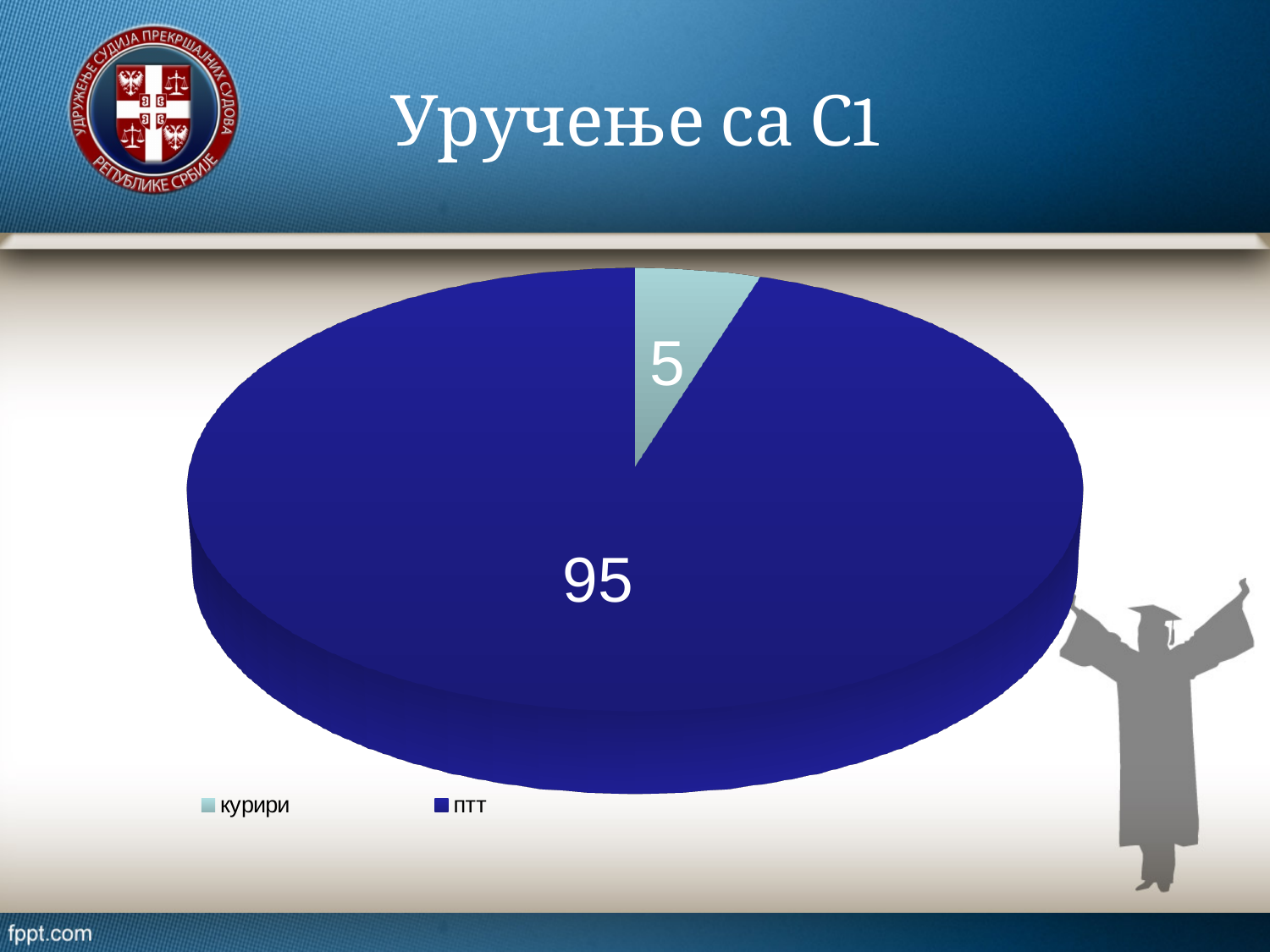
What is the value for курири? 5 Which category has the smallest slice? курири What is the total of the two slice values? 100 What is the title of the slide containing the chart? Уручење са С1 What is the value for птт? 95 How many entries does the legend list? 2 What is the difference between the values for птт and курири? 90 What share of the pie does the птт slice represent? 95% Which is larger, the value for курири or the value for птт? птт How many slices does the pie chart have? 2 Which category has the largest slice? птт What kind of chart is shown on the slide? pie chart